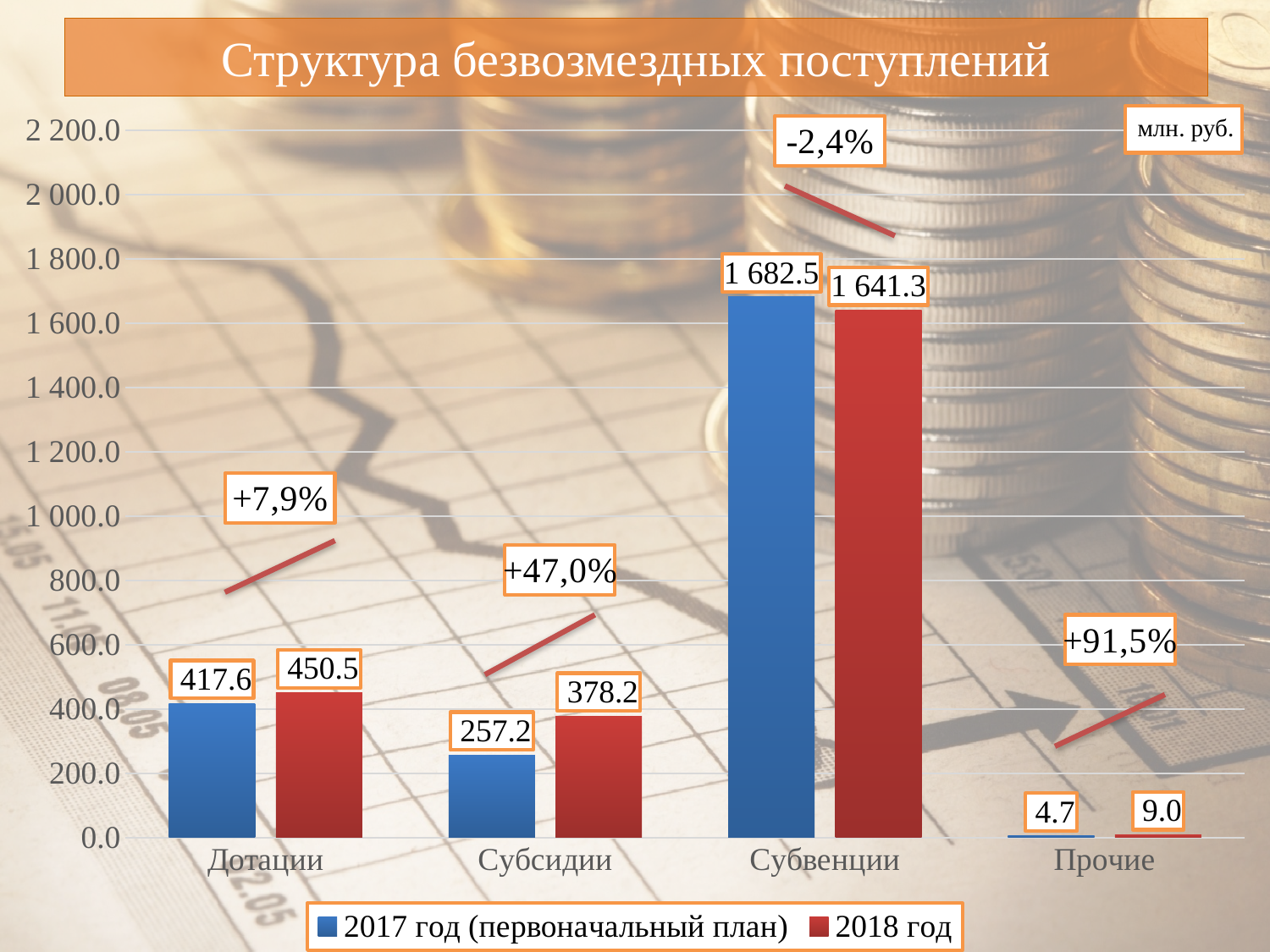
What is the difference between the 2018 год and 2017 год (первоначальный план) values for Субсидии? 121.0 For Субвенции, which is larger: the 2017 год (первоначальный план) value or the 2018 год value? 2017 год (первоначальный план) What is the value for Субсидии in the 2018 год series? 378.2 Which category has the highest value in the 2018 год series? Субвенции How many series does the legend list? 2 What is the value for Дотации in the 2017 год (первоначальный план) series? 417.6 What kind of chart is shown on the slide? Bar chart What is the value for Субвенции in the 2018 год series? 1 641.3 What is the value for Прочие in the 2017 год (первоначальный план) series? 4.7 Which category has the lowest value in the 2017 год (первоначальный план) series? Прочие How many categories are shown on the x axis? 4 What percentage change is annotated above the Прочие bars? +91,5%